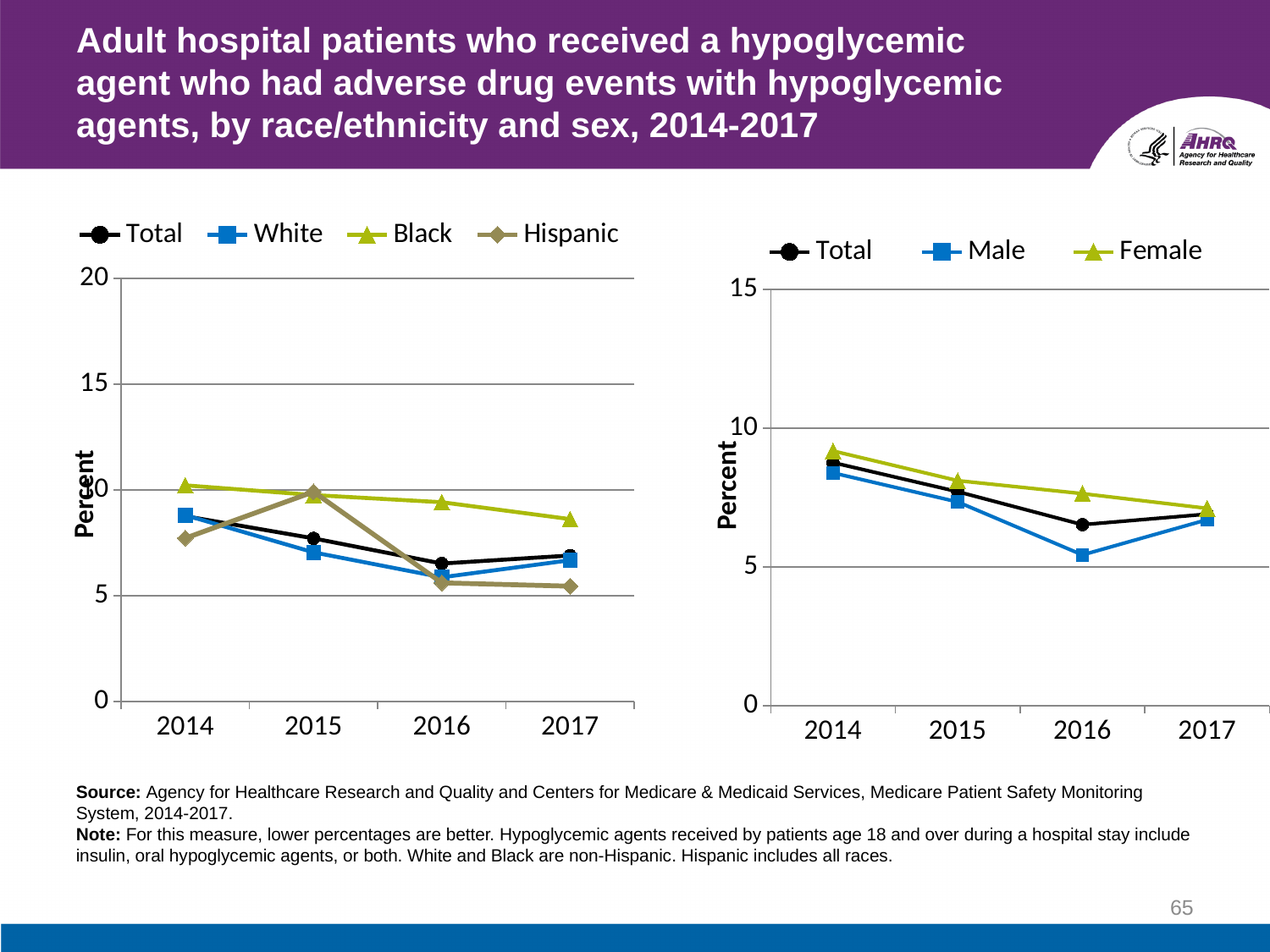
In the left chart (by race/ethnicity), which group has the lowest value in 2017? Hispanic How many series does the legend of the left chart (by race/ethnicity) list? 4 In the right chart (by sex), is the value for Female in 2014 greater or less than 10? less In the right chart (by sex), which series has the lowest value in 2016? Male In the left chart (by race/ethnicity), is the value for Hispanic in 2017 greater or less than 10? less In the right chart (by sex), does the Female series rise or fall from 2014 to 2017? Fall What kind of chart is the left chart (by race/ethnicity)? Line chart How many series does the legend of the right chart (by sex) list? 3 In the left chart (by race/ethnicity), is the value for Black in 2016 larger than the value for White in 2016? Yes, Black How many years are shown on the x axis of the right chart (by sex)? 4 In the left chart (by race/ethnicity), which group has the highest value in 2014? Black In the right chart (by sex), which series has the highest value in 2014? Female